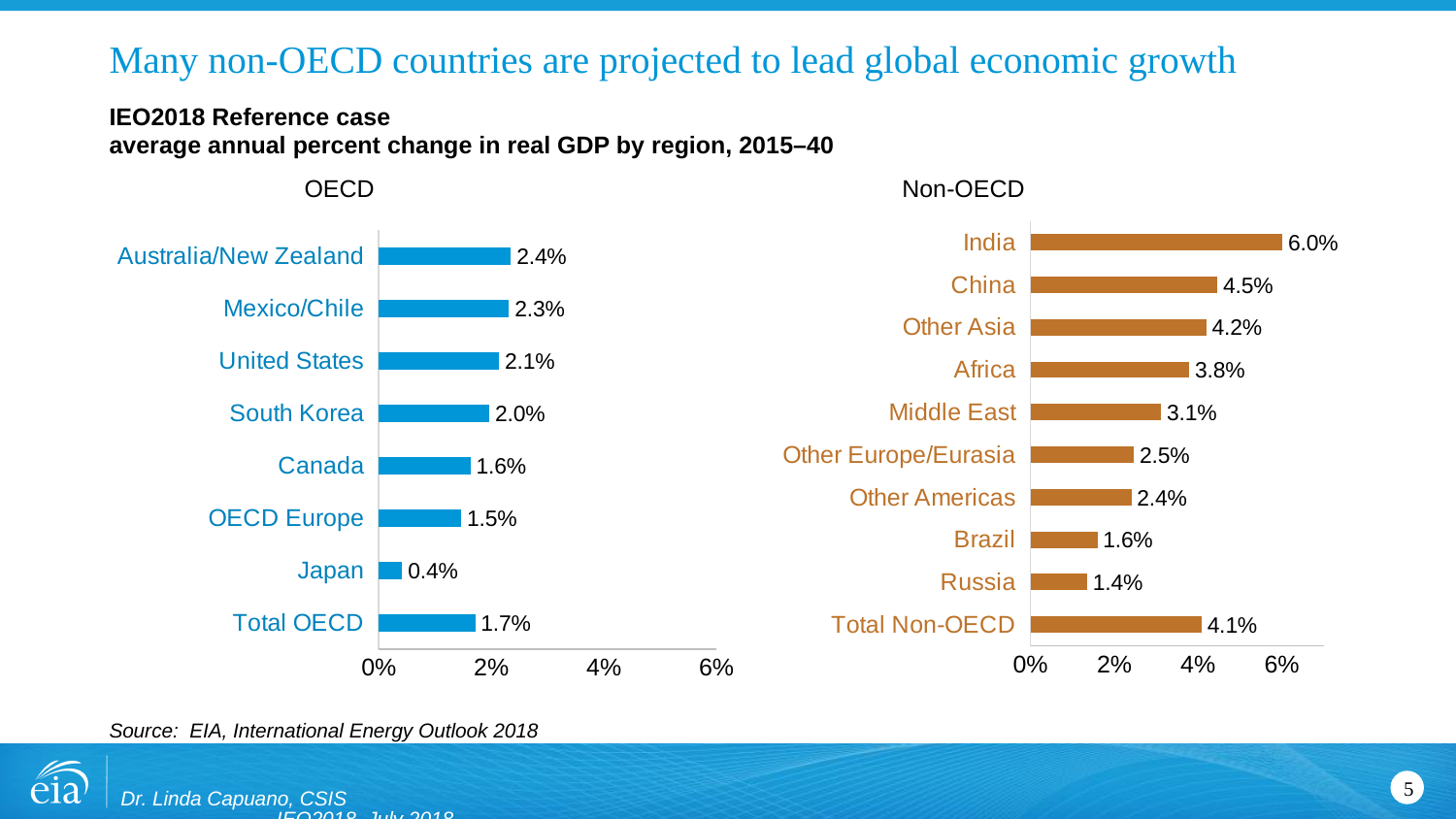
In the OECD chart, what is the value for Total OECD? 1.7% How many regions (bars) are shown in the OECD chart? 8 In the Non-OECD chart, what is the difference between India and China? 1.5% In the OECD chart, what is the value for Australia/New Zealand? 2.4% In the Non-OECD chart, which region has the highest value? India In the Non-OECD chart, which region has the lowest value? Russia What type of chart is the OECD chart? Bar chart In the OECD chart, which region has the lowest value? Japan In the OECD chart, what is the difference between the United States and Japan? 1.7% Which is larger: Total OECD in the OECD chart or Total Non-OECD in the Non-OECD chart? Total Non-OECD In the Non-OECD chart, what is the value for Africa? 3.8% How many regions (bars) are shown in the Non-OECD chart? 10